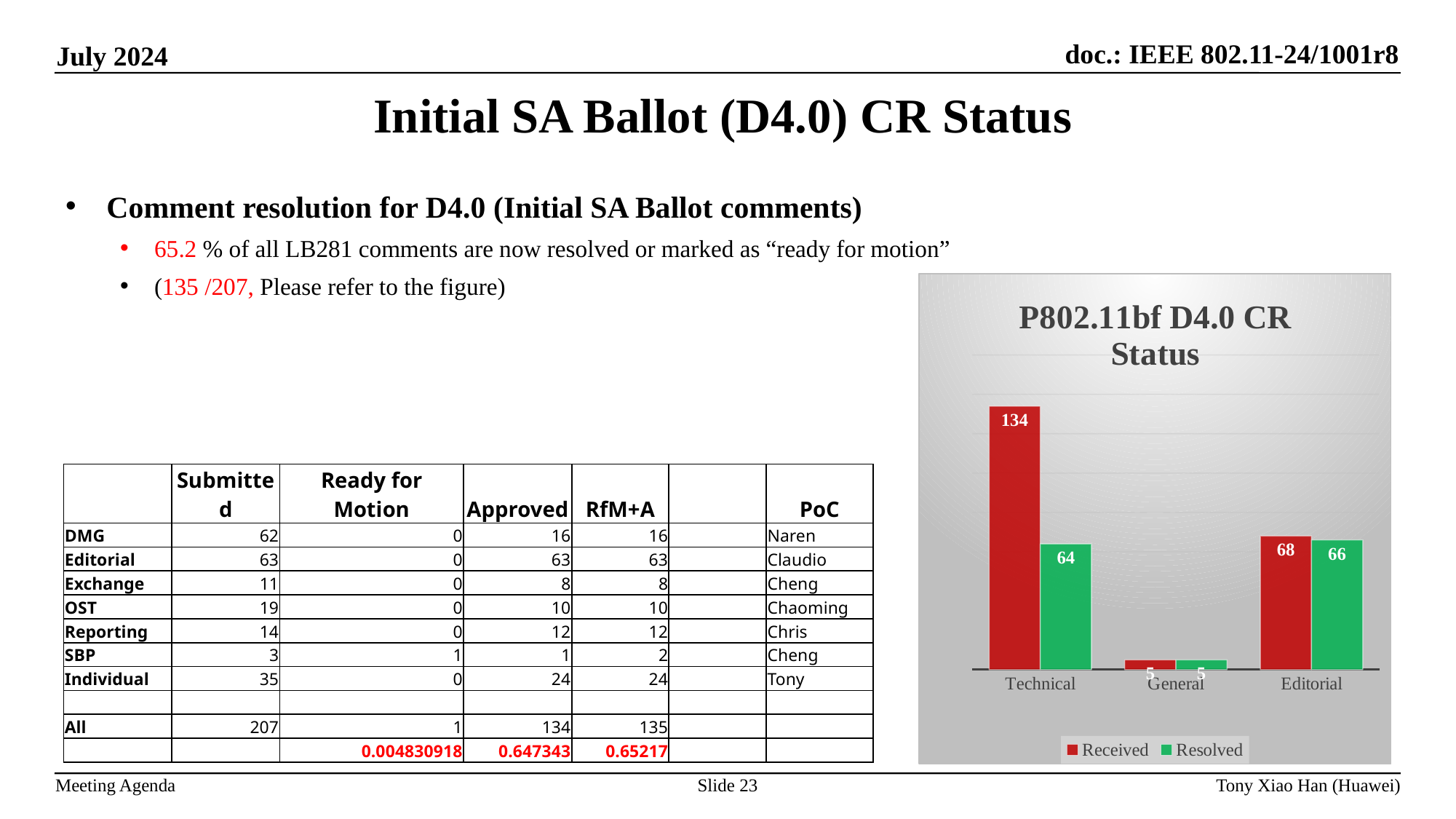
What is the Received value for Editorial? 68 What is the Resolved value for Technical? 64 What is the title of the chart? P802.11bf D4.0 CR Status How many categories are shown on the x axis of the chart? 3 What is the Received value for Technical? 134 What is the Resolved value for Editorial? 66 Which category has the highest Received value? Technical What type of chart is shown on the slide? bar chart Which category has the lowest Resolved value? General What is the difference between Received and Resolved for Technical? 70 Which is larger for Editorial, Received or Resolved? Received How many series does the chart legend list? 2